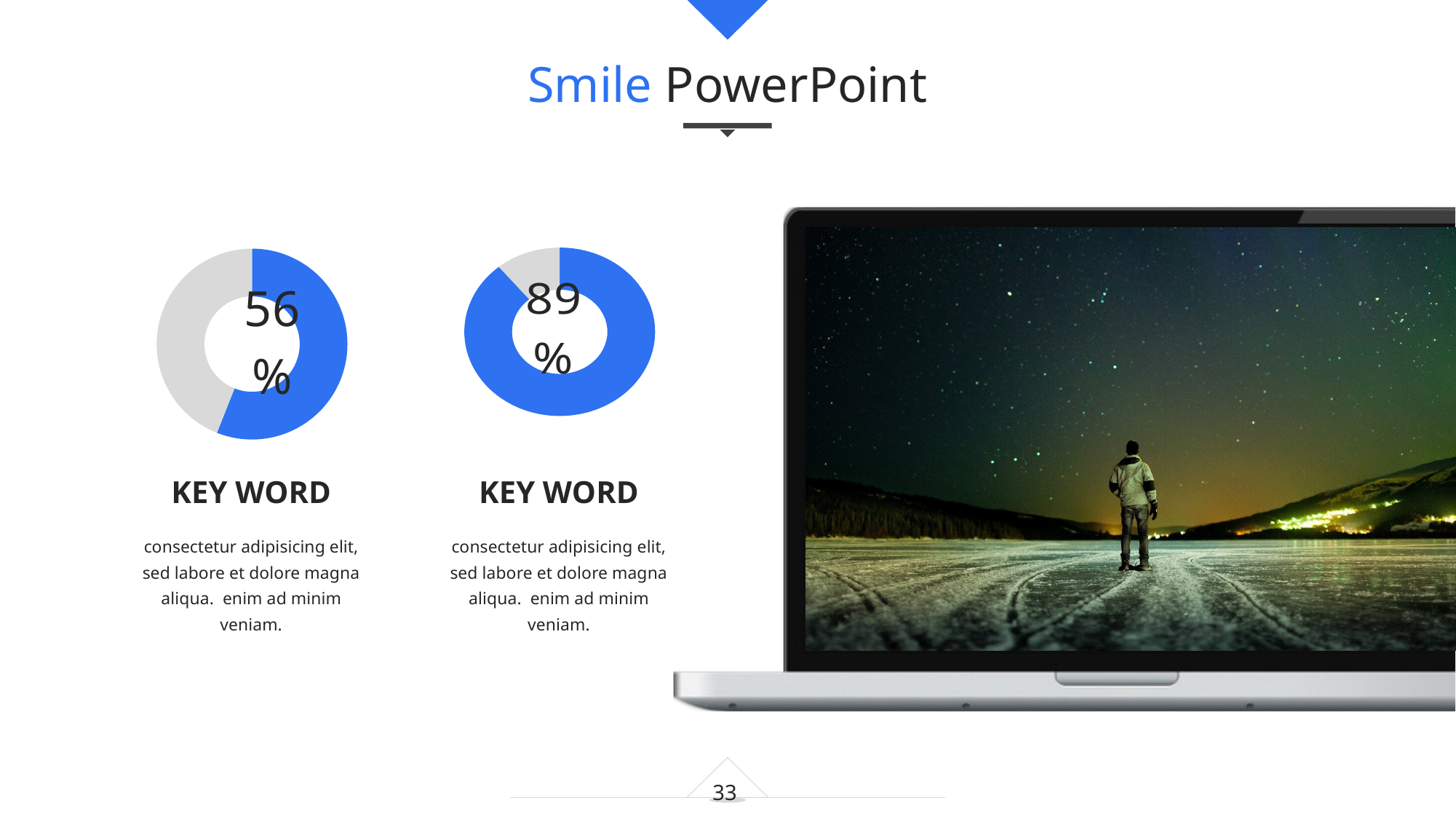
What colour is the filled portion of the donut charts? blue Which donut chart shows the lowest percentage? the left one (56%) What percentage is shown in the right donut chart? 89% How many donut charts are on the slide? 2 Which donut chart shows the higher percentage, the left one or the right one? the right one What is the difference in percentage points between the right donut chart (89%) and the left donut chart (56%)? 33 What kind of chart is used to display the 56% and 89% values? donut chart What percentage is shown in the left donut chart? 56% What label appears beneath each donut chart? KEY WORD Which donut chart shows the highest percentage? the right one (89%)